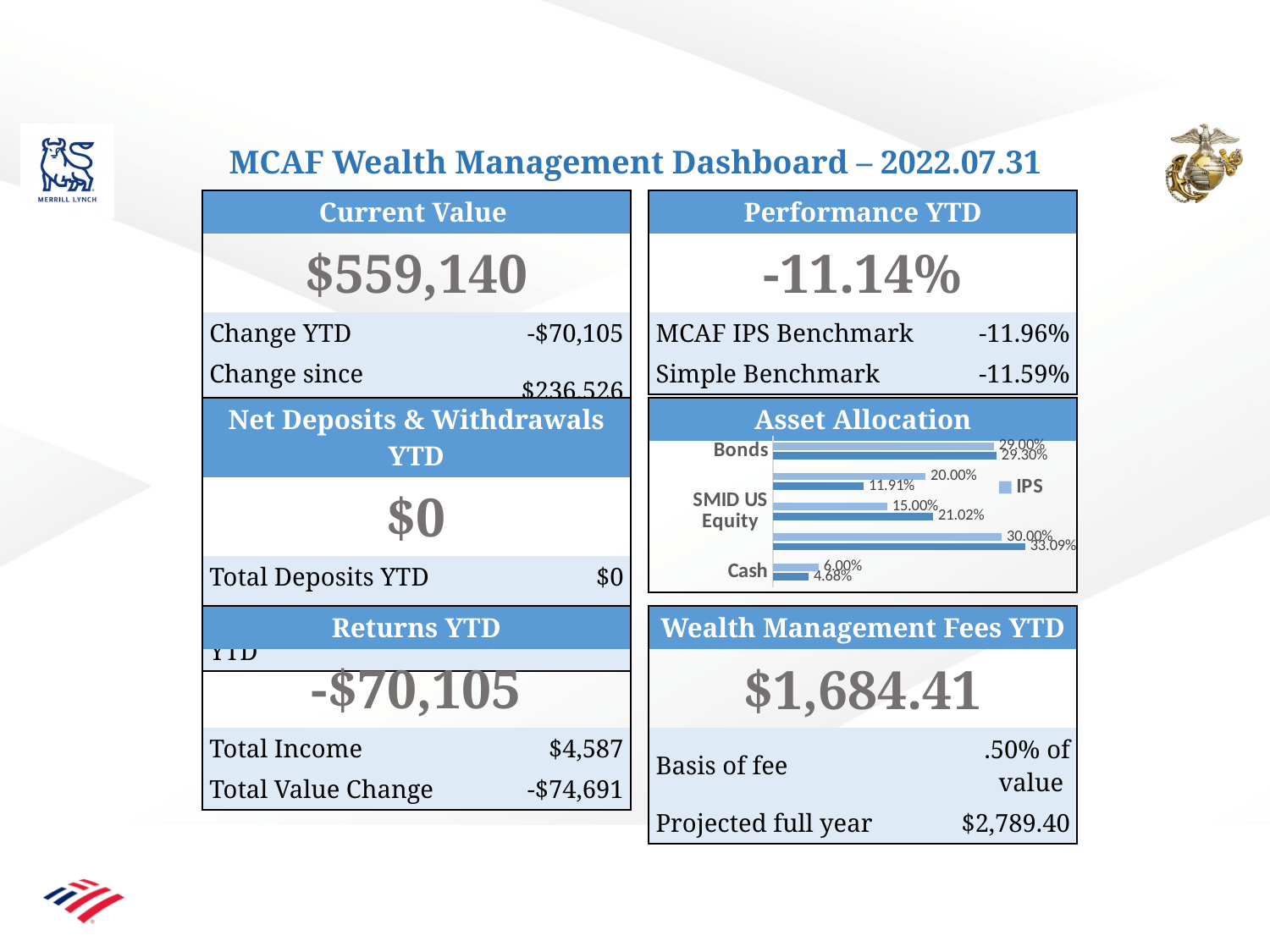
In the Asset Allocation chart, which of Bonds, SMID US Equity and Cash has the highest IPS value? Bonds In the Asset Allocation chart, what is the difference between the two bars shown for Cash? 1.32% What is the title of the bar chart on the slide? Asset Allocation What type of chart is the Asset Allocation chart? bar chart In the Asset Allocation chart, what is the IPS value for SMID US Equity? 15.00% In the Asset Allocation chart, what is the difference between the IPS values for Bonds and SMID US Equity? 14.00% In the Asset Allocation chart, what is the IPS value for Bonds? 29.00% In the Asset Allocation chart, is the IPS value for Bonds larger or smaller than the IPS value for Cash? larger In the Asset Allocation chart, what is the IPS value for Cash? 6.00% In the Asset Allocation chart, what is the value of the darker bar for Cash? 4.68% In the Asset Allocation chart, which of Bonds, SMID US Equity and Cash has the lowest IPS value? Cash In the Asset Allocation chart, what is the value of the darker bar for SMID US Equity? 21.02%